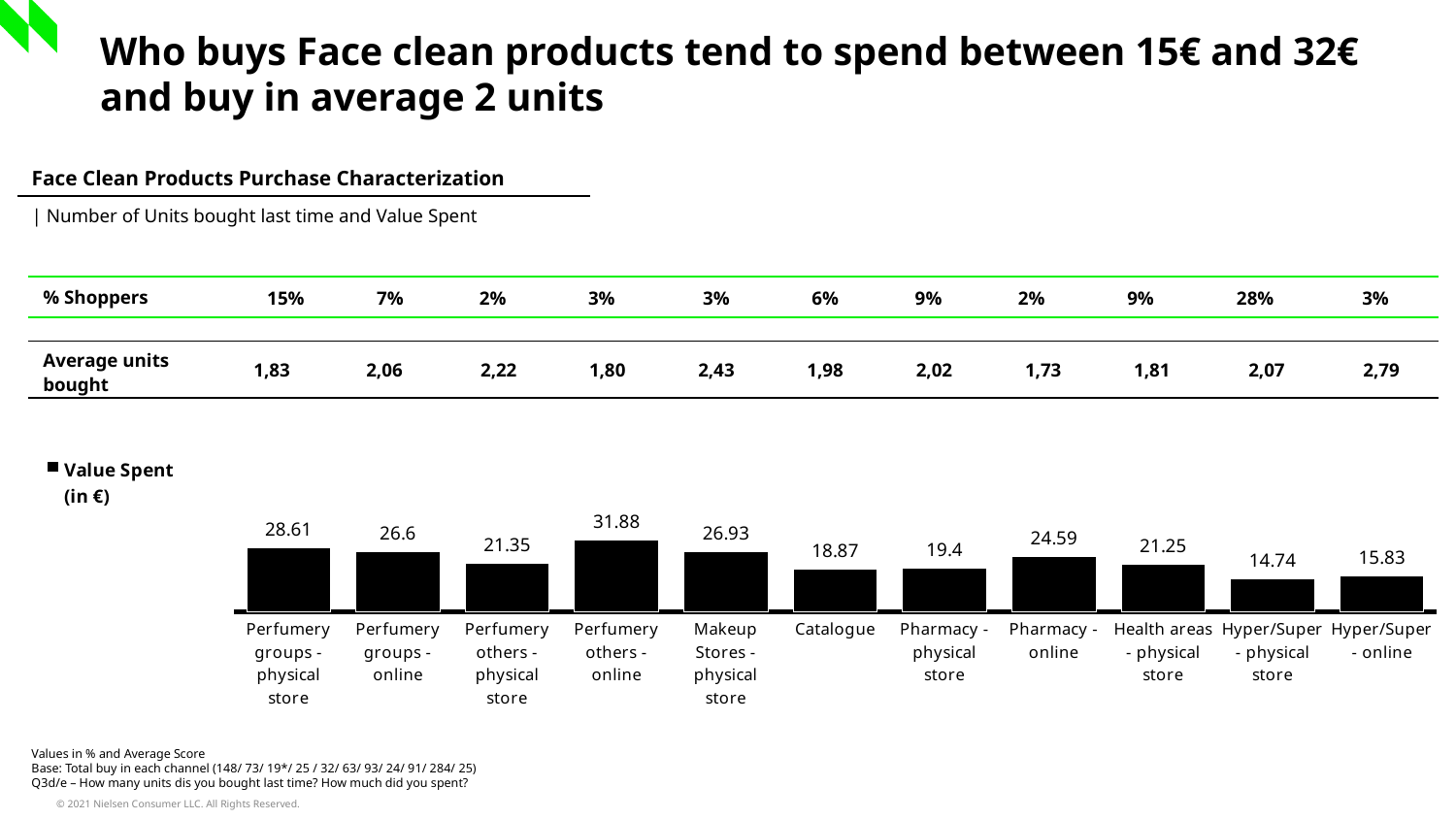
Which channel has the highest value spent? Perfumery others - online What is the value spent (in €) for Pharmacy - online? 24.59 What is the value spent (in €) for Catalogue? 18.87 What is the difference in value spent between Perfumery groups - physical store and Perfumery groups - online? 2.01 What is the value spent (in €) for Hyper/Super - online? 15.83 What is the difference in value spent between the highest channel (Perfumery others - online) and the lowest channel (Hyper/Super - physical store)? 17.14 What type of chart is used to show Value Spent? Bar chart How many series does the legend of the chart list? 1 What is the value spent (in €) for Perfumery others - online? 31.88 How many channels are shown in the Value Spent chart? 11 Which channel has the lowest value spent? Hyper/Super - physical store Which has a higher value spent: Makeup Stores - physical store or Health areas - physical store? Makeup Stores - physical store